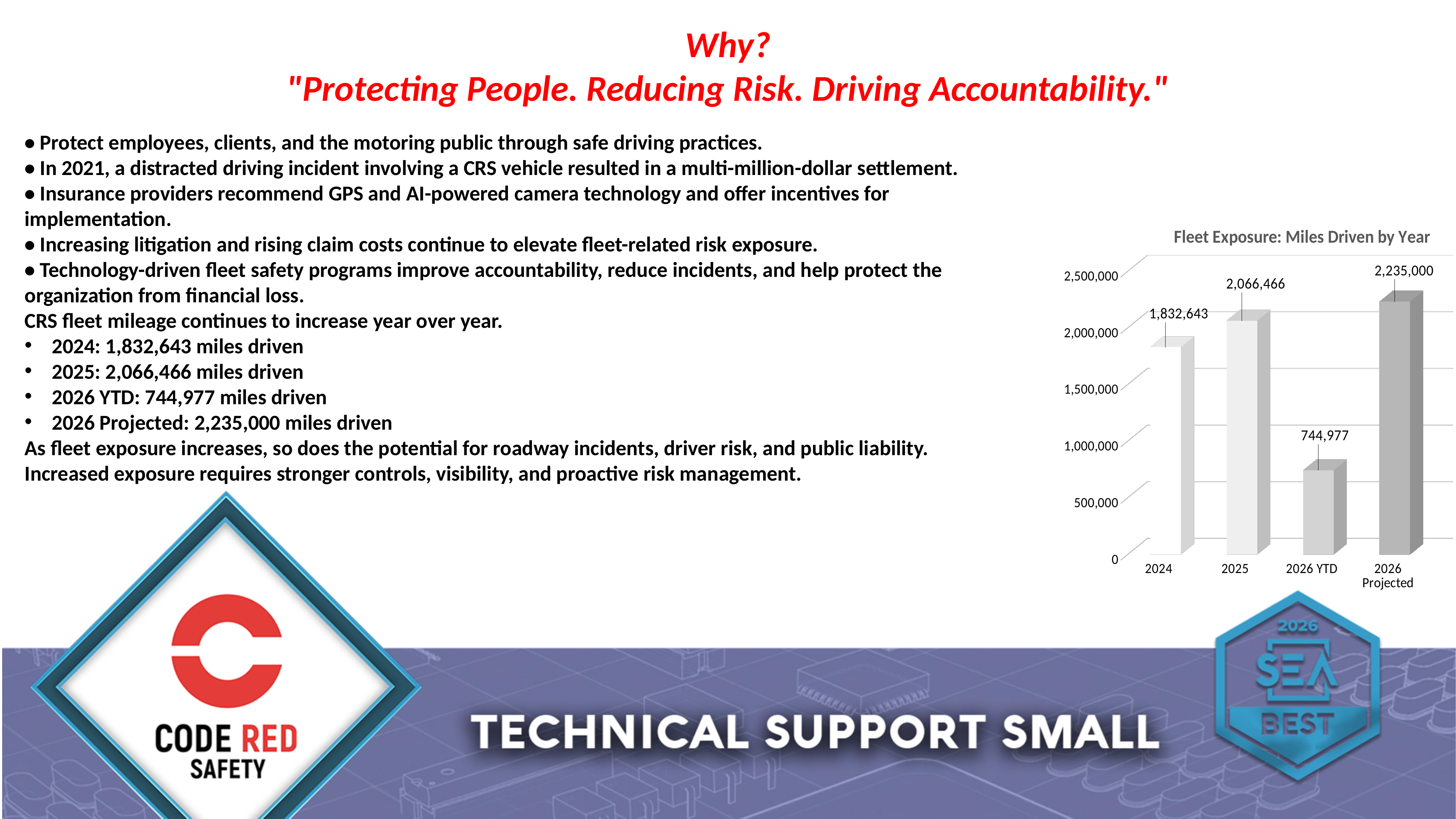
What type of chart is shown on the slide? Bar chart What is the value for 2025 in the chart? 2,066,466 Which is larger, the value for 2024 or the value for 2026 YTD? 2024 What is the difference between the values for 2026 Projected and 2025? 168,534 How many categories are plotted in the chart? 4 What is the value for 2026 Projected in the chart? 2,235,000 What is the value for 2026 YTD in the chart? 744,977 Which category has the highest value in the chart? 2026 Projected What is the value for 2024 in the chart? 1,832,643 What is the difference between the values for 2025 and 2024? 233,823 Which category has the lowest value in the chart? 2026 YTD What is the title of the chart? Fleet Exposure: Miles Driven by Year